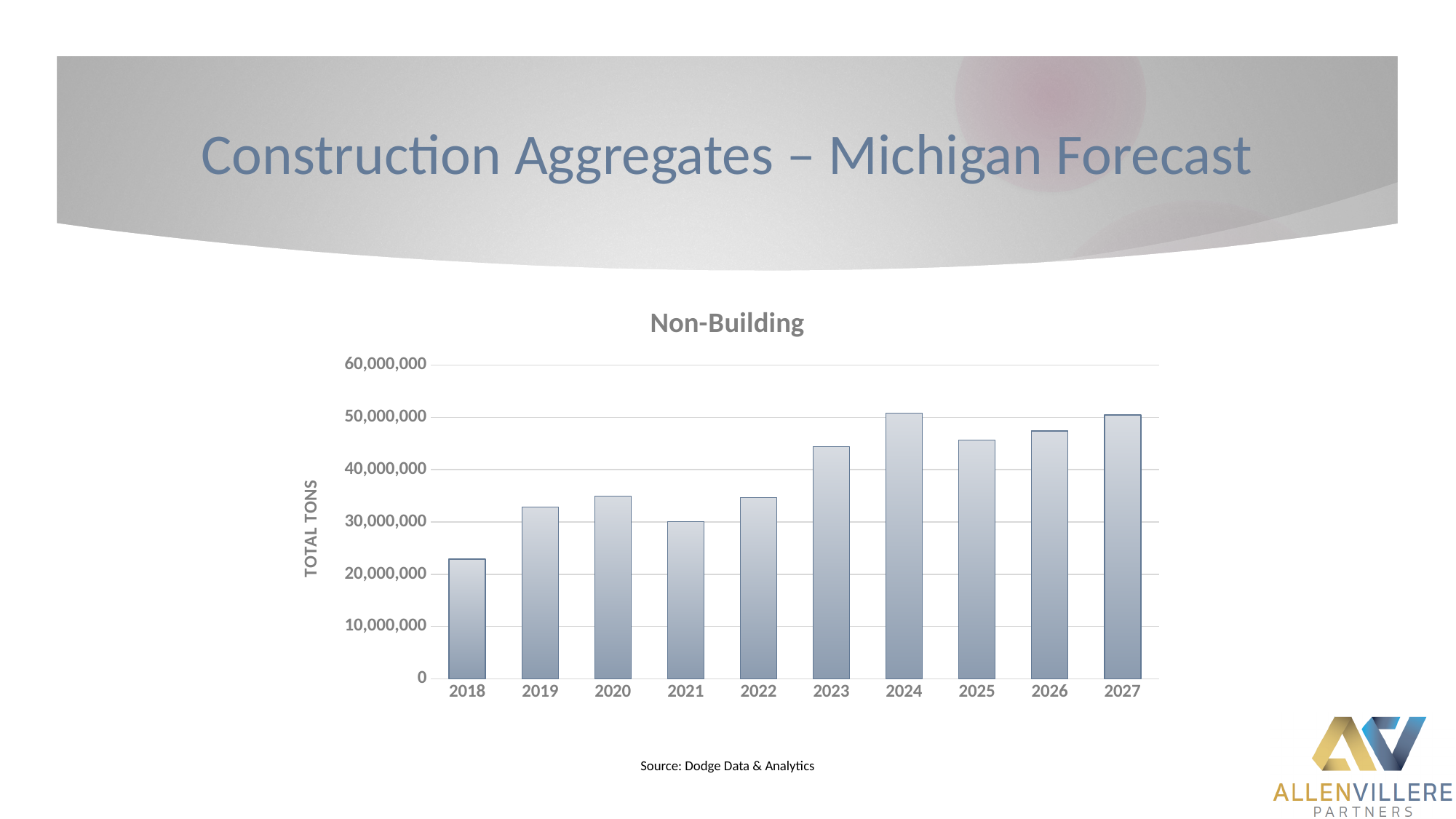
How many years are shown on the x axis of the Non-Building chart? 10 Is the value for 2025 greater or less than 50,000,000? less Which year has the larger value, 2020 or 2021? 2020 Is the value for 2018 greater or less than 20,000,000? greater What is the label on the vertical axis of the chart? TOTAL TONS Is the value for 2019 greater or less than 40,000,000? less Which year has the larger value, 2022 or 2023? 2023 Which year has the larger value, 2025 or 2026? 2026 What kind of chart is shown on the slide? bar chart Which year has the lowest value in the Non-Building chart? 2018 Overall, do the values rise or fall from 2018 to 2027? rise